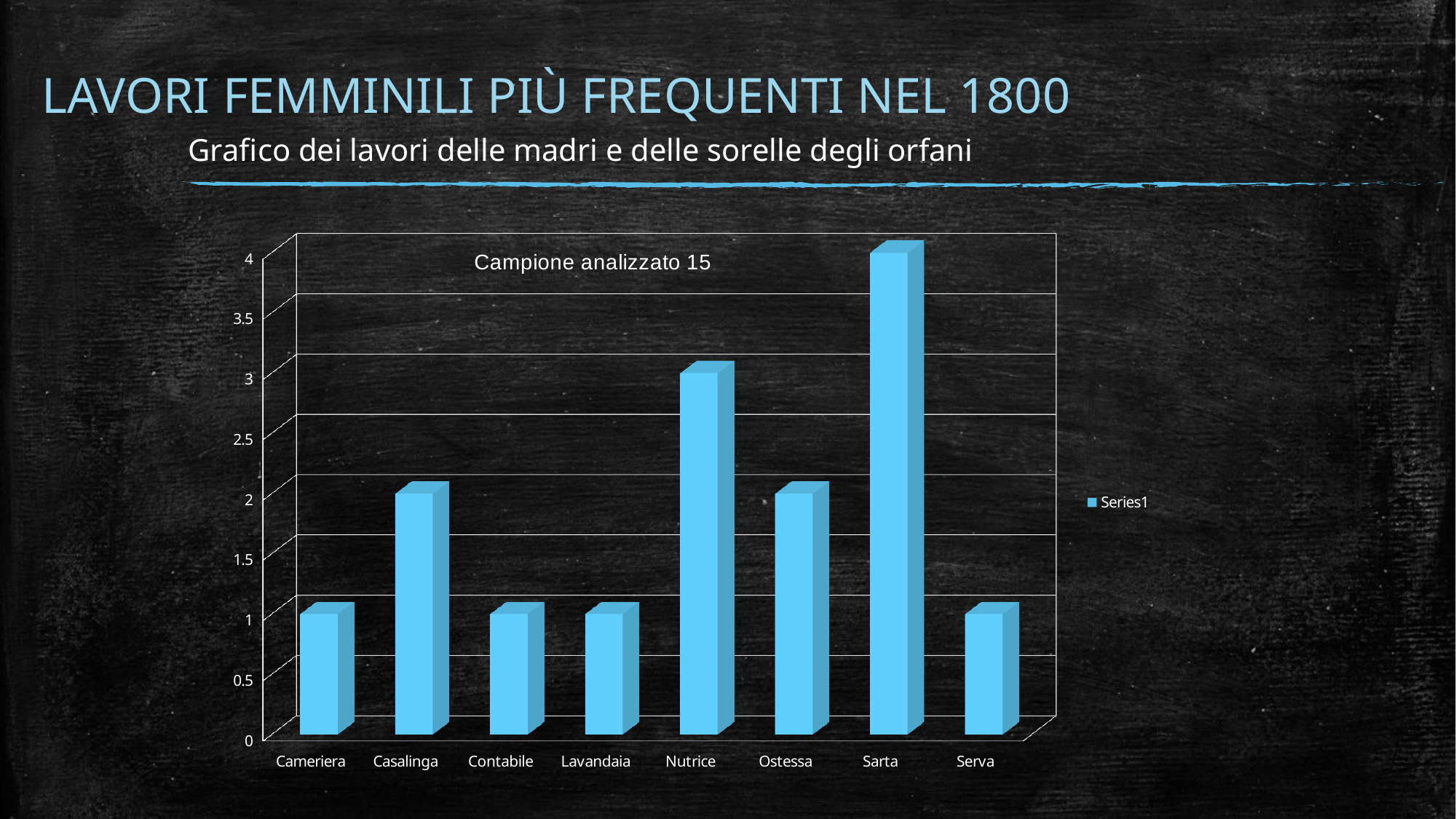
What is the value for Serva? 1 What is the difference between the values for Sarta and Nutrice? 1 How many categories are shown on the x axis? 8 Which category has the highest value? Sarta What text is shown inside the chart area above the bars? Campione analizzato 15 What is the value for Sarta? 4 What kind of chart is shown on the slide? bar chart Is the value for Nutrice greater or less than 2.5? greater How many series does the legend list? 1 What is the value for Nutrice? 3 Which is larger, the value for Ostessa or the value for Lavandaia? Ostessa What is the value for Casalinga? 2